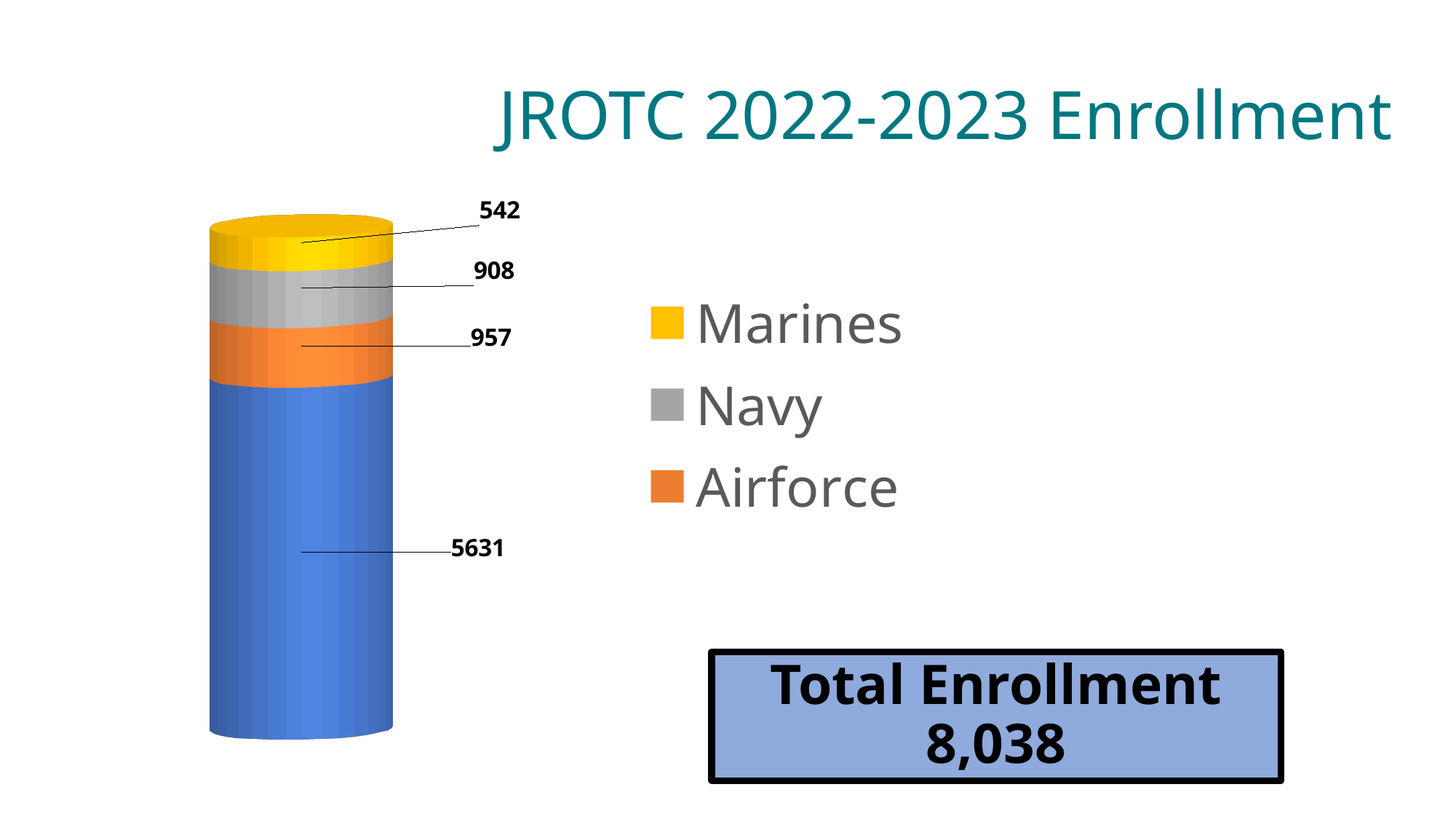
What is the enrollment value shown for Navy? 908 What is the difference between the Navy and Marines enrollment values? 366 What is the enrollment value shown for Marines? 542 How many entries does the legend list? 3 What is the enrollment value shown for Airforce? 957 What is the total enrollment shown for the stacked bar? 8,038 What is the value of the largest segment in the stacked bar? 5631 What kind of chart is shown on the slide? Stacked bar chart Of the branches listed in the legend, which has the lowest enrollment? Marines Which has the larger enrollment, Navy or Airforce? Airforce What is the difference between the Airforce and Navy enrollment values? 49 What is the title of the chart? JROTC 2022-2023 Enrollment